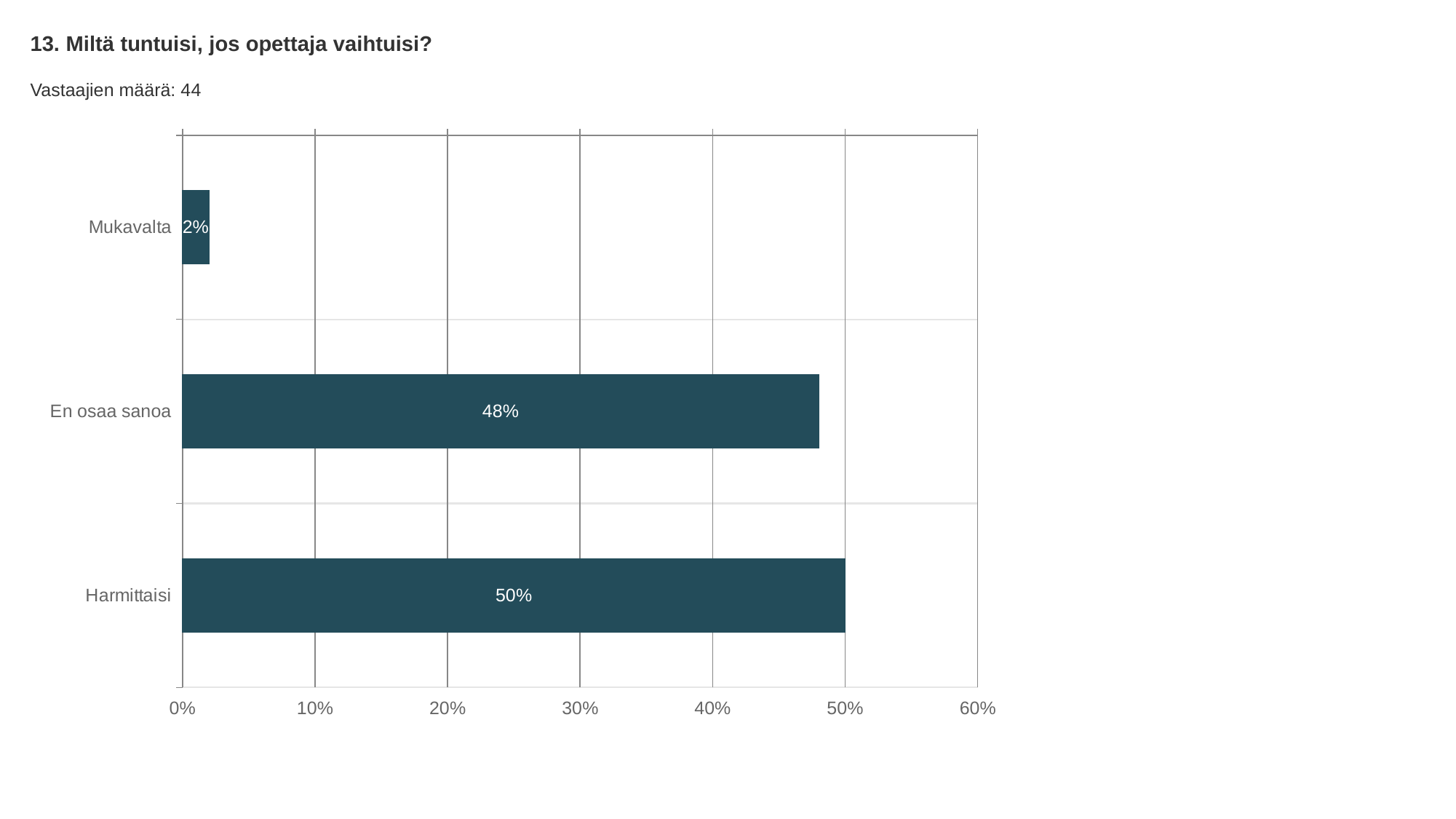
Which is larger, the value for En osaa sanoa or the value for Mukavalta? En osaa sanoa What is the value for Mukavalta? 2% What is the value for Harmittaisi? 50% What is the difference between the values for Harmittaisi and Mukavalta? 48% Which category has the highest value? Harmittaisi Is the value for En osaa sanoa greater or less than 40%? greater What is the difference between the values for En osaa sanoa and Mukavalta? 46% What is the value for En osaa sanoa? 48% How many categories are shown in the chart? 3 What is the title of the chart? 13. Miltä tuntuisi, jos opettaja vaihtuisi? Which category has the lowest value? Mukavalta What kind of chart is shown on the slide? bar chart